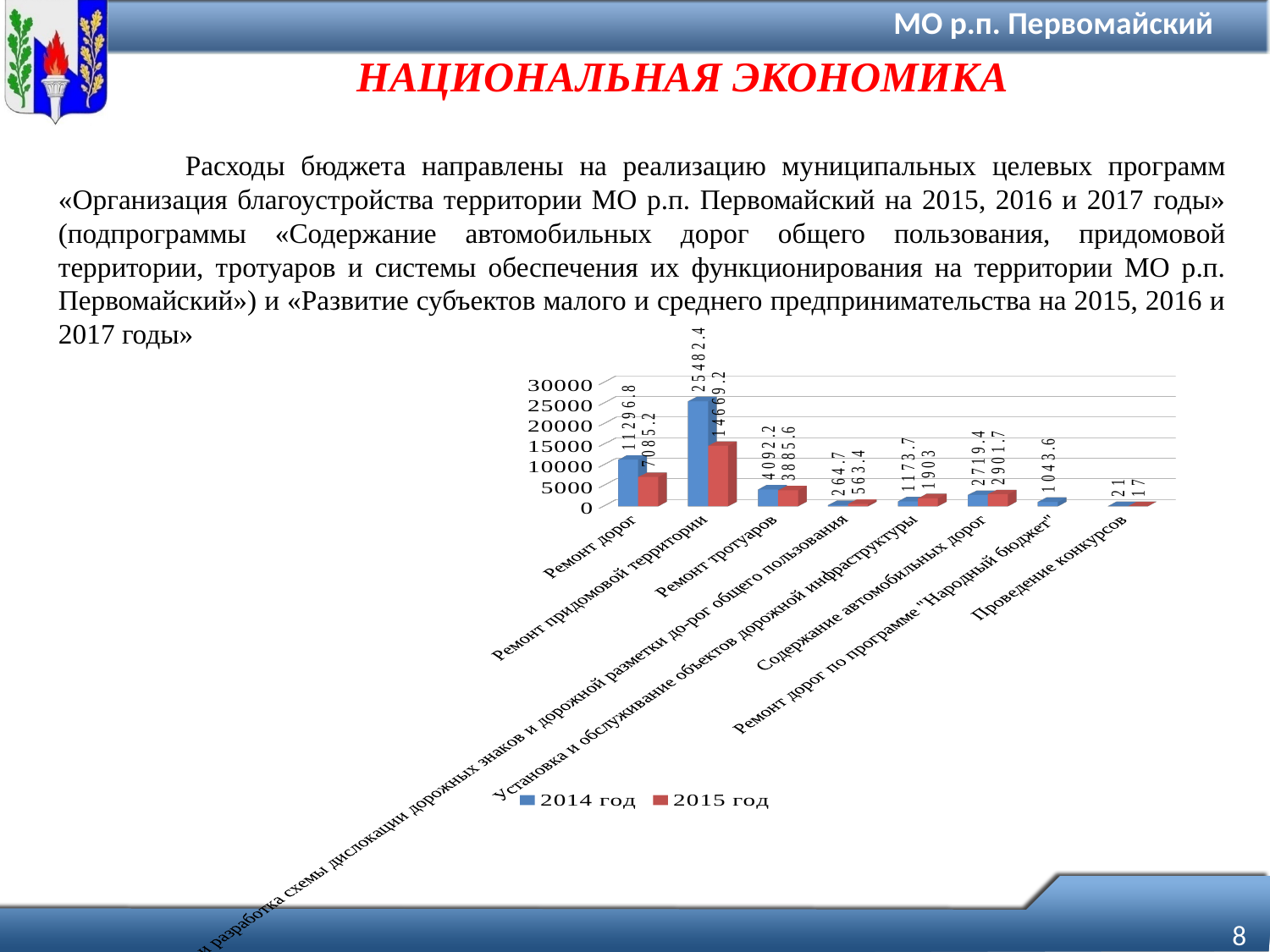
What type of chart is shown on the slide? bar chart What is the 2014 год value for Ремонт придомовой территории? 25482.4 Which category has the lowest 2015 год value? Проведение конкурсов How many series does the chart legend list? 2 What are the two series named in the chart legend? 2014 год and 2015 год What is the 2015 год value for Ремонт тротуаров? 3885.6 What is the 2015 год value for Ремонт придомовой территории? 14669.2 Which category has the highest 2014 год value? Ремонт придомовой территории What is the 2014 год value for Ремонт дорог? 11296.8 What is the 2015 год value for Содержание автомобильных дорог? 2901.7 For Содержание автомобильных дорог, which is larger: the 2014 год value or the 2015 год value? 2015 год What is the difference between the 2014 год and 2015 год values for Ремонт придомовой территории? 10813.2